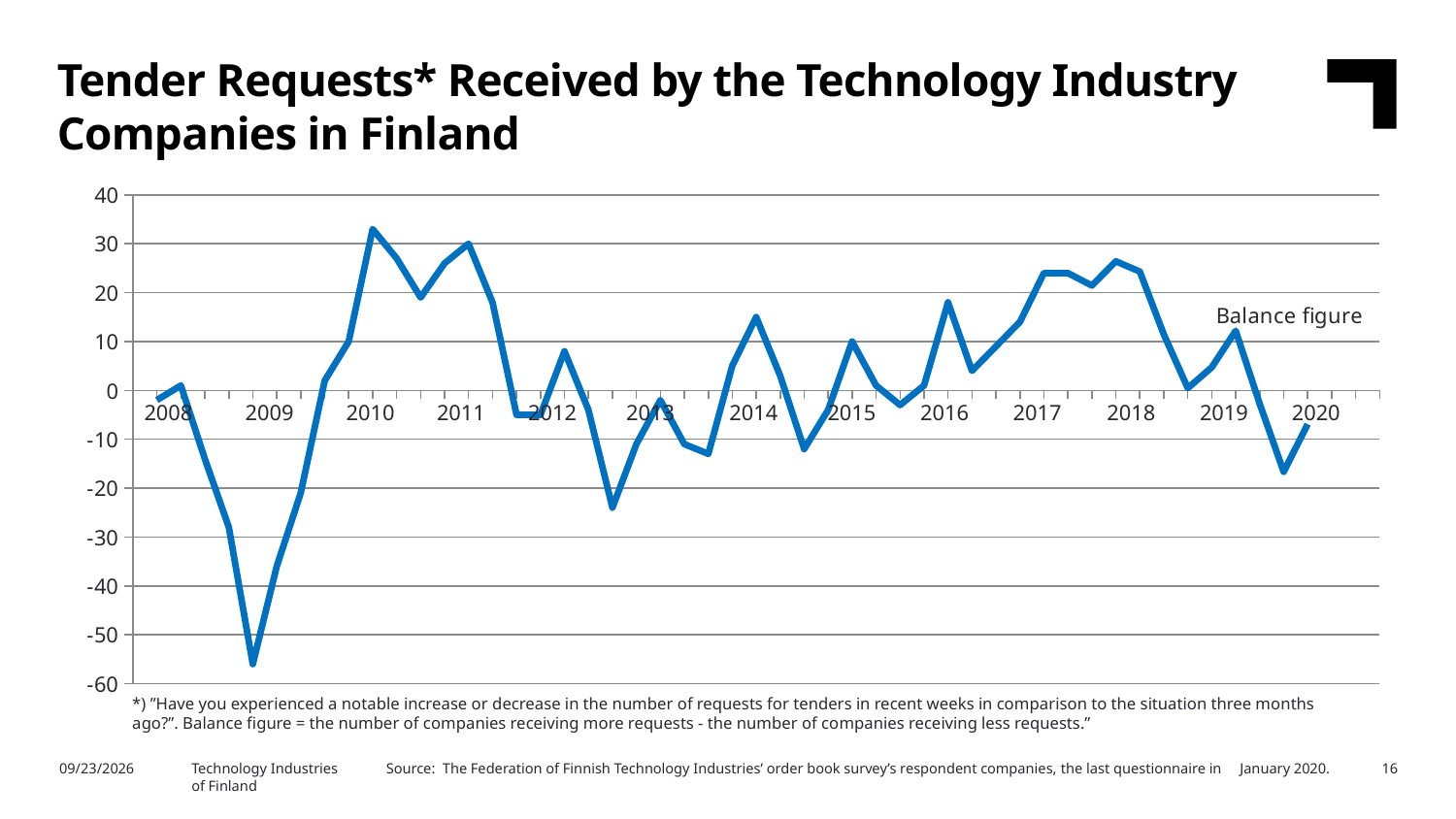
Which is larger: the peak of the line in 2010 or the low point in 2009? the peak in 2010 Is the highest value of the line (in 2010) greater or less than 30? greater Is the lowest value of the line (in 2009) greater or less than -50? less What kind of chart is shown on the slide? line chart Is the final value of the line, at 2020, greater or less than 0? less How many years are labelled on the x axis of the chart? 13 What is the highest value shown on the y axis? 40 How many data series does the chart plot? 1 In which year does the line reach its lowest value? 2009 What is the name of the series shown on the chart? Balance figure Does the line rise or fall between 2008 and its low point in 2009? falls